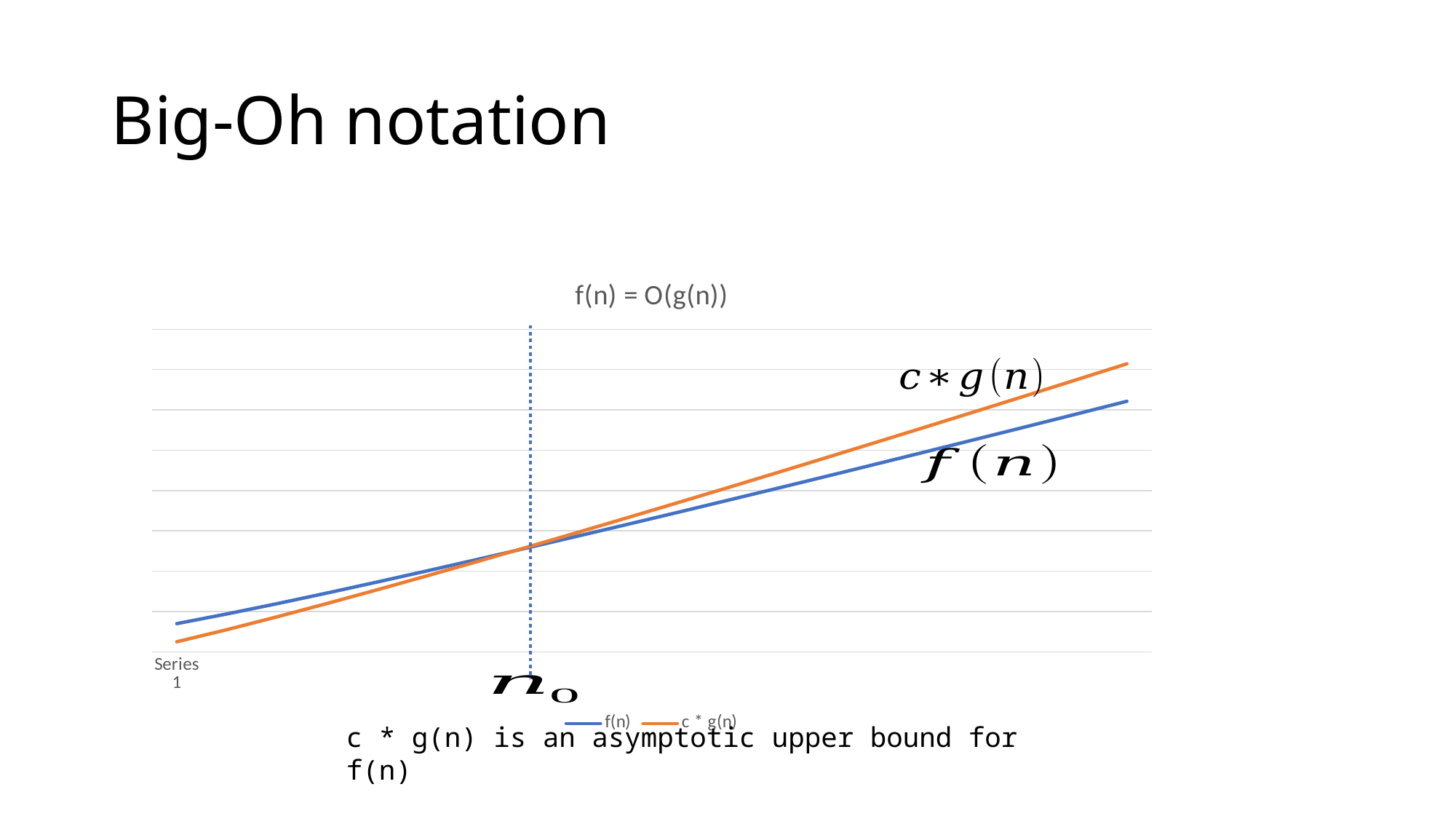
What kind of chart is shown on the slide? line chart Do the values of the f(n) series rise or fall from left to right? rise At the right end of the chart, which series has the higher value, f(n) or c * g(n)? c * g(n) How many series does the chart's legend list? 2 Which series has the lowest value on the chart? c * g(n) What is the title of the chart? f(n) = O(g(n)) Which series reaches the highest value on the chart? c * g(n) Do the values of the c * g(n) series rise or fall from left to right? rise At the left end of the chart, which series has the higher value, f(n) or c * g(n)? f(n) Which series is drawn in orange? c * g(n)